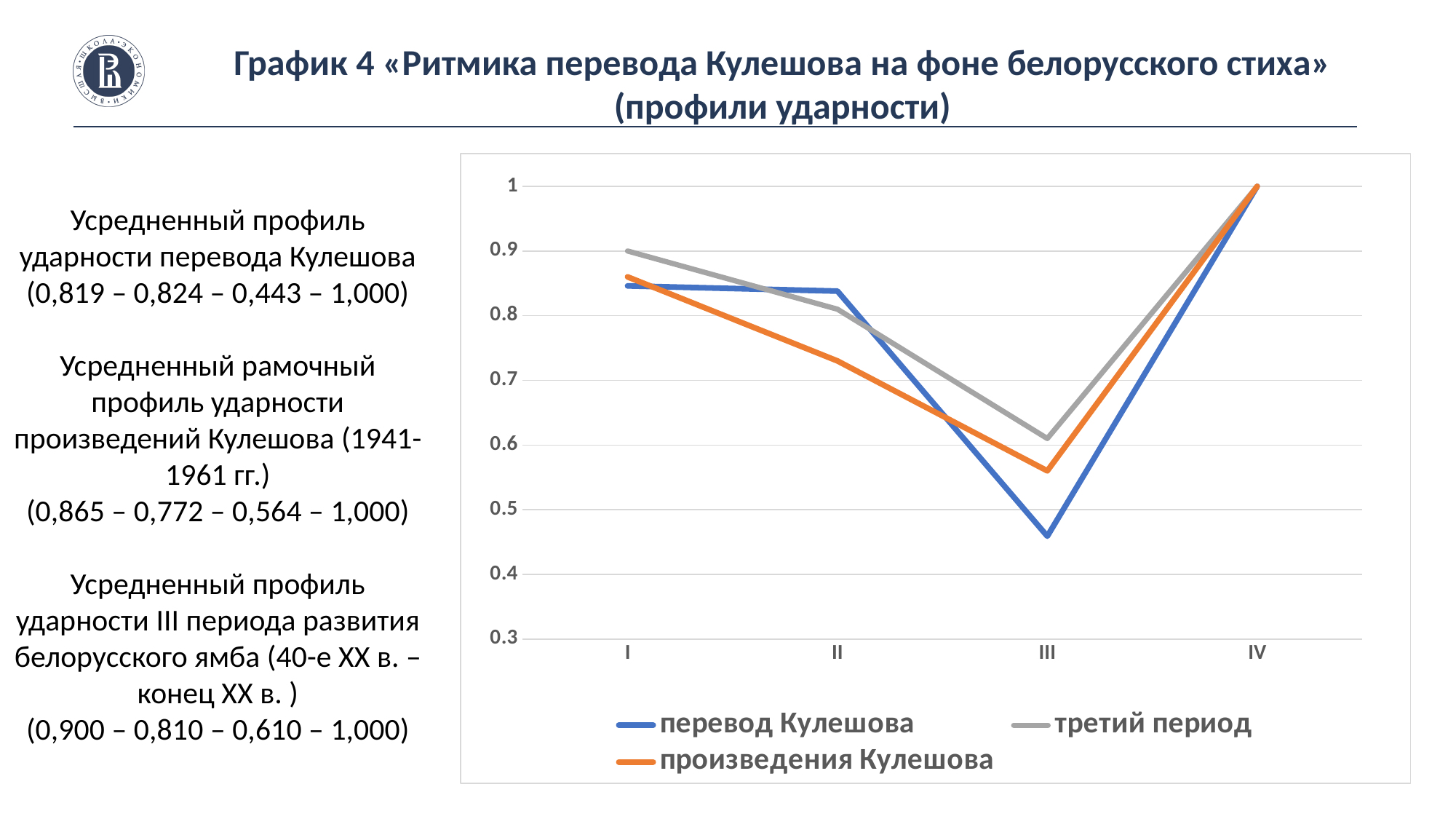
What is the value of перевод Кулешова at category IV? 1 How many categories are on the x axis? 4 At category III, which is larger: третий период or перевод Кулешова? третий период What kind of chart is shown on the slide? line chart At which category do all three series reach their highest value? IV What colour is the line for произведения Кулешова? orange Is the value for произведения Кулешова at category III greater or less than 0.6? less Is the value for третий период at category I greater or less than 0.8? greater How many series does the legend list? 3 Does the перевод Кулешова line rise or fall from category II to category III? fall Is the value for перевод Кулешова at category III greater or less than 0.5? less At which category does перевод Кулешова reach its lowest value? III